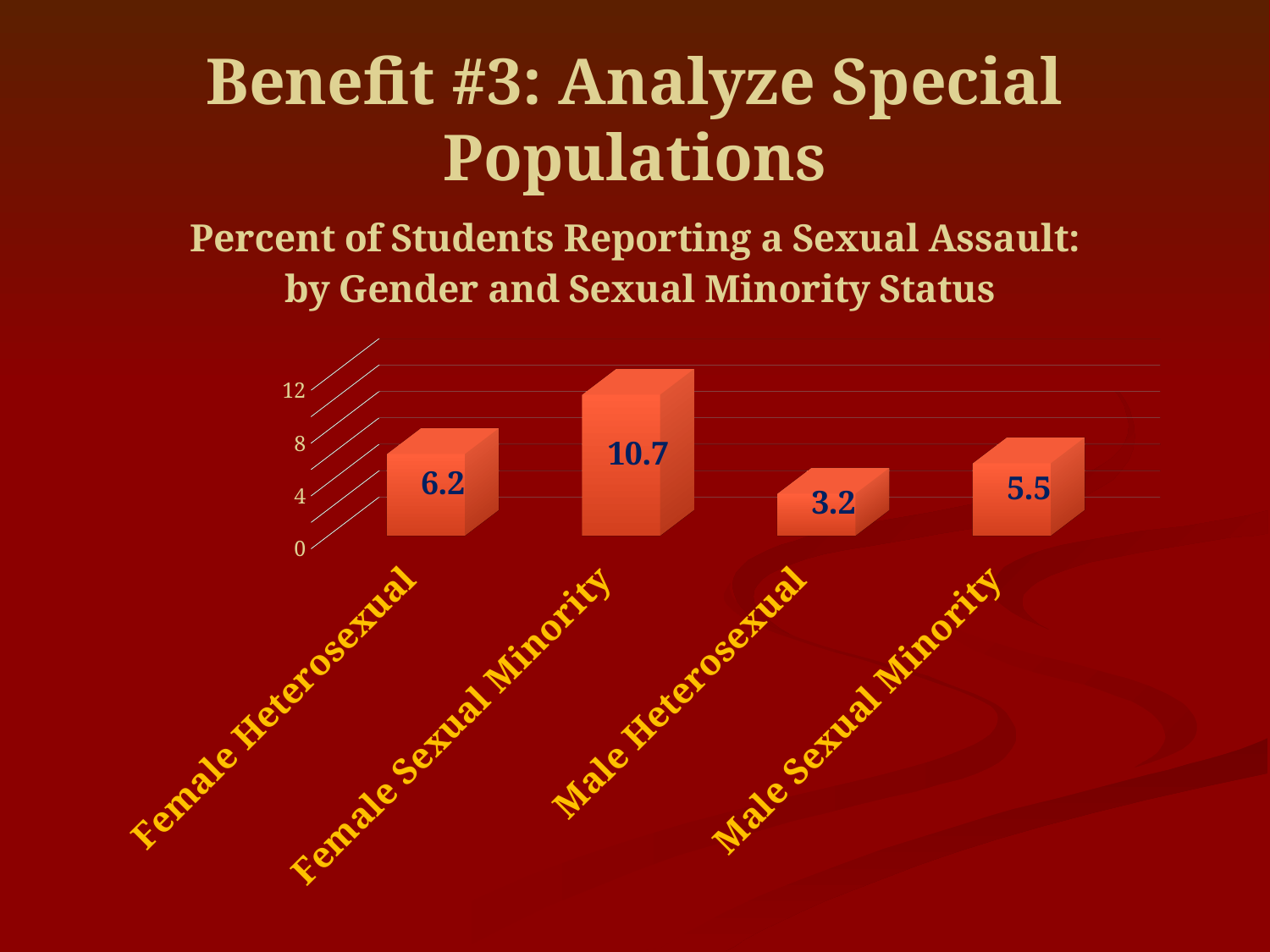
What is the value for Male Heterosexual? 3.2 Which category has the highest value? Female Sexual Minority What kind of chart is shown on the slide? Bar chart Which is larger, the value for Female Heterosexual or the value for Male Sexual Minority? Female Heterosexual What is the difference between the values for Female Sexual Minority and Female Heterosexual? 4.5 What is the value for Male Sexual Minority? 5.5 What is the difference between the values for Male Sexual Minority and Male Heterosexual? 2.3 What is the title of the chart? Percent of Students Reporting a Sexual Assault: by Gender and Sexual Minority Status What is the value for Female Sexual Minority? 10.7 What is the value for Female Heterosexual? 6.2 Which category has the lowest value? Male Heterosexual How many categories are shown in the chart? 4